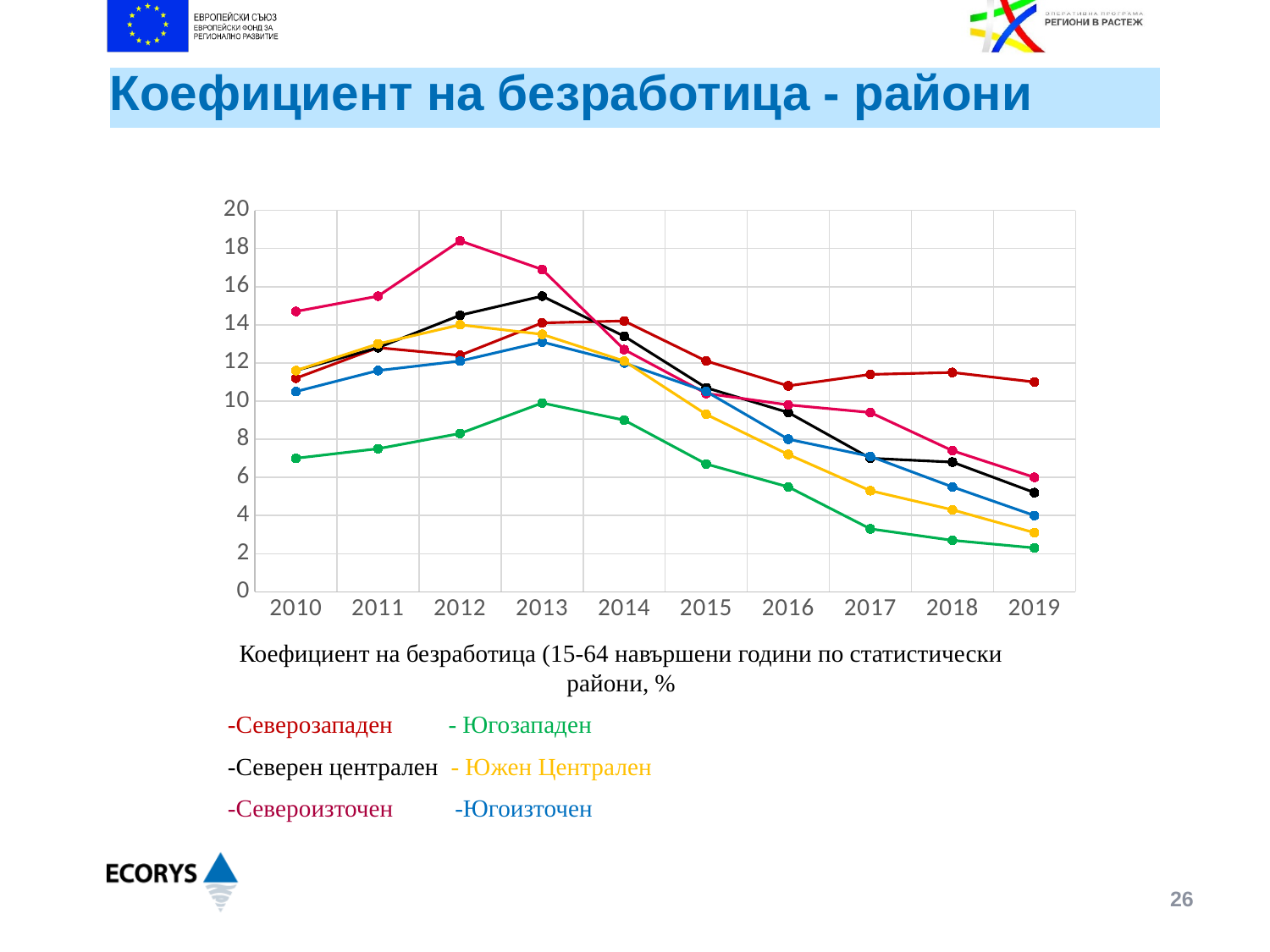
Which region has the lowest unemployment rate in 2019? Югозападен Which region has the highest unemployment rate in 2012? Североизточен Which region has the highest unemployment rate in 2019? Северозападен What kind of chart is shown on the slide? line chart Is the value for Северозападен in 2019 greater or less than 10? greater What is the title of the slide containing the chart? Коефициент на безработица - райони Is the value for Североизточен in 2012 greater or less than 16? greater Does the value for Югозападен rise or fall from 2013 to 2019? fall Is the value for Югозападен in 2019 greater or less than 4? less How many regions (series) are listed in the legend below the chart? 6 In 2010, which is larger: the value for Югозападен or the value for Североизточен? Североизточен How many years are shown along the x axis of the chart? 10